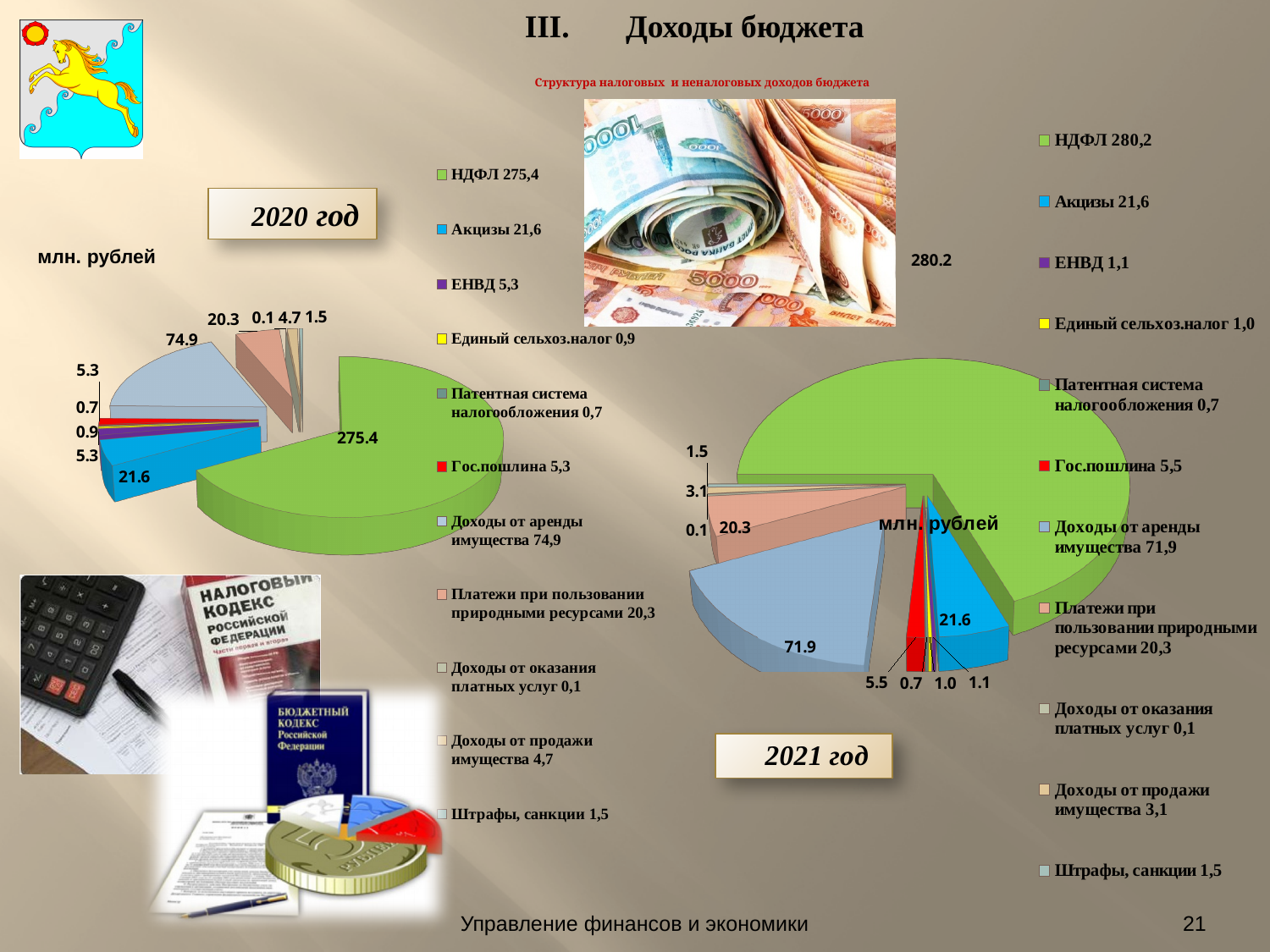
In the 2020 год pie chart, what is the value for НДФЛ? 275.4 Which is larger in the 2020 год pie chart: Акцизы or Платежи при пользовании природными ресурсами? Акцизы In the 2021 год pie chart, which category has the smallest value? Доходы от оказания платных услуг Which is larger: Доходы от продажи имущества in the 2020 год chart or in the 2021 год chart? 2020 год What type of chart is used to show the 2020 год budget revenue structure? Pie chart How many categories does the 2021 год pie chart legend list? 11 In the 2021 год pie chart, what is the value for Гос.пошлина? 5.5 In the 2020 год pie chart, what is the difference between Доходы от аренды имущества and Платежи при пользовании природными ресурсами? 54.6 What is the difference between НДФЛ in the 2021 год chart and НДФЛ in the 2020 год chart? 4.8 In the 2021 год pie chart, what is the value for Доходы от аренды имущества? 71.9 What unit of measurement is indicated for the values in the pie charts? млн. рублей In the 2020 год pie chart, which category has the largest value? НДФЛ